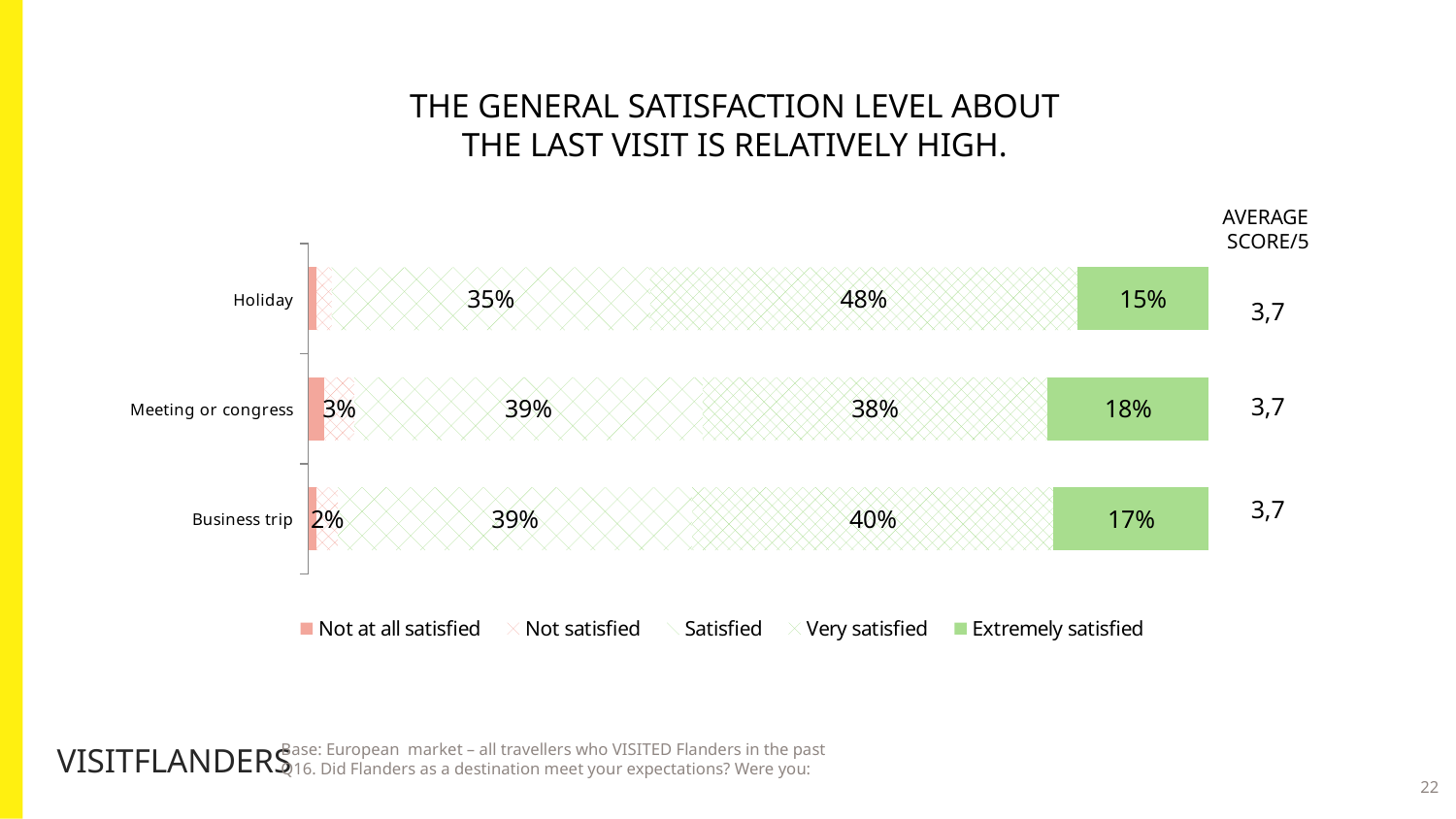
What percentage of Business trip travellers were Satisfied? 39% Which category has the lowest share of Very satisfied travellers? Meeting or congress For Business trip, which is larger: the Satisfied share or the Very satisfied share? Very satisfied What percentage of Meeting or congress travellers were Extremely satisfied? 18% What percentage of Holiday travellers were Satisfied? 35% For Holiday, how many percentage points higher is the Very satisfied share than the Extremely satisfied share? 33 percentage points What is the average score out of 5 shown for Holiday? 3,7 How many trip categories are shown in the chart? 3 Which category has the highest share of Extremely satisfied travellers? Meeting or congress How many series does the legend list? 5 What percentage of Holiday travellers were Very satisfied? 48% What kind of chart is shown on the slide? Stacked horizontal bar chart